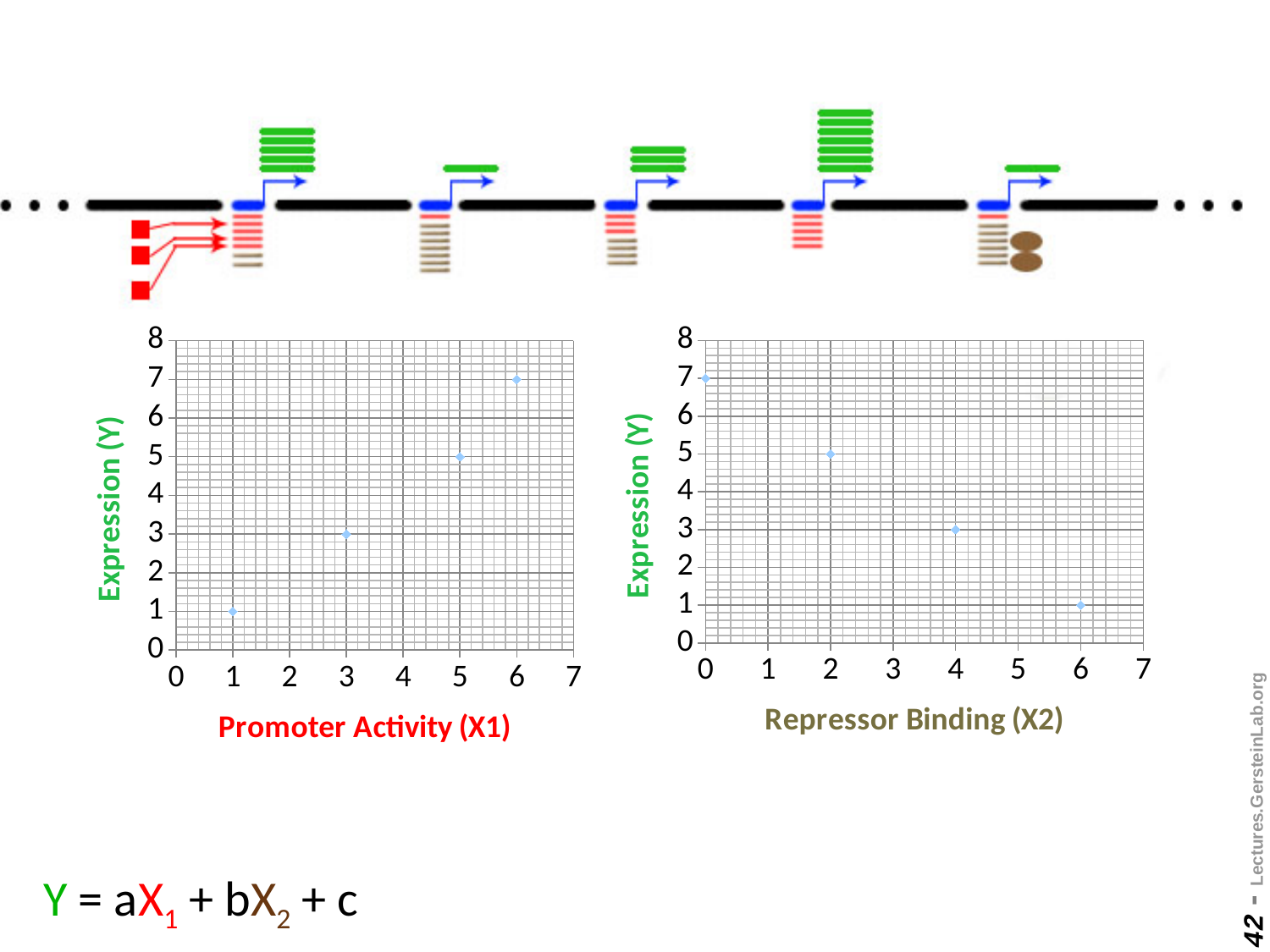
On the left chart, which Promoter Activity (X1) value has the lowest Expression (Y)? 1 On the right chart, what is the difference in Expression (Y) between Repressor Binding (X2) = 0 and Repressor Binding (X2) = 6? 6 What kind of chart is the left chart with x axis 'Promoter Activity (X1)'? scatter chart How many data points are plotted on the right chart (Repressor Binding (X2))? 4 What is the y-axis label of the right chart? Expression (Y) On the left chart, what is the Expression (Y) value at Promoter Activity (X1) = 6? 7 On the left chart, what is the Expression (Y) value at Promoter Activity (X1) = 3? 3 On the right chart, what is the Expression (Y) value at Repressor Binding (X2) = 0? 7 On the right chart, what is the Expression (Y) value at Repressor Binding (X2) = 4? 3 How many data points are plotted on the left chart (Promoter Activity (X1))? 4 On the right chart, does Expression (Y) rise or fall as Repressor Binding (X2) increases? fall On the left chart, does Expression (Y) rise or fall as Promoter Activity (X1) increases? rise